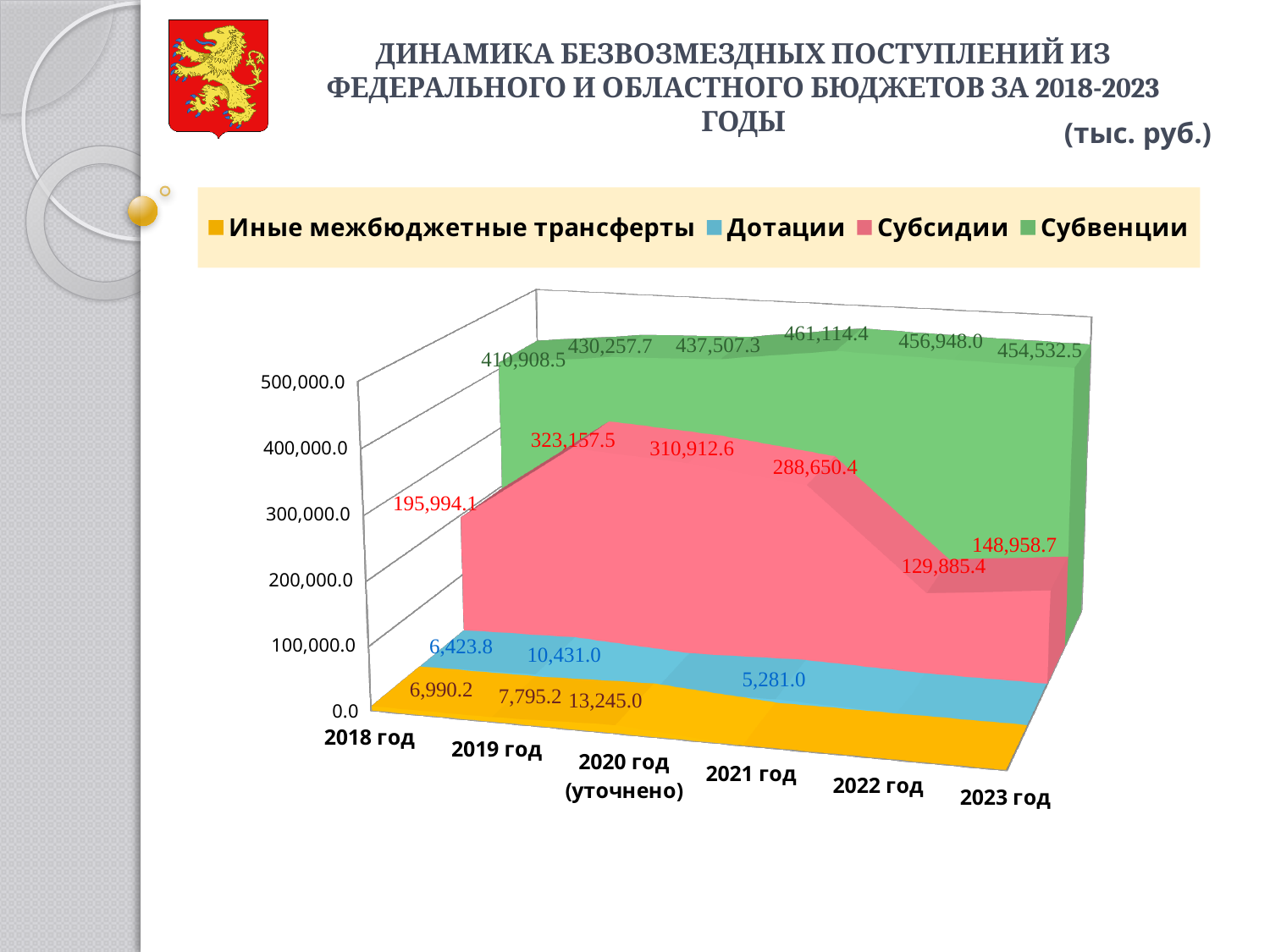
What is the value of Субвенции for 2023 год? 454,532.5 Do the Субвенции values rise or fall from 2018 год to 2021 год? Rise Which is larger: the Субсидии value for 2021 год or for 2023 год? 2021 год What is the value of Субсидии for 2022 год? 129,885.4 How many series does the legend list? 4 What kind of chart is shown on the slide? Area chart In which year is the value of Субсидии lowest? 2022 год In which year is the value of Субвенции highest? 2021 год How many years (categories) are plotted along the x axis? 6 What is the difference between the Субсидии values for 2019 год and 2018 год? 127,163.4 What is the value of Субвенции for 2018 год? 410,908.5 Which colour represents Дотации in the legend? Blue